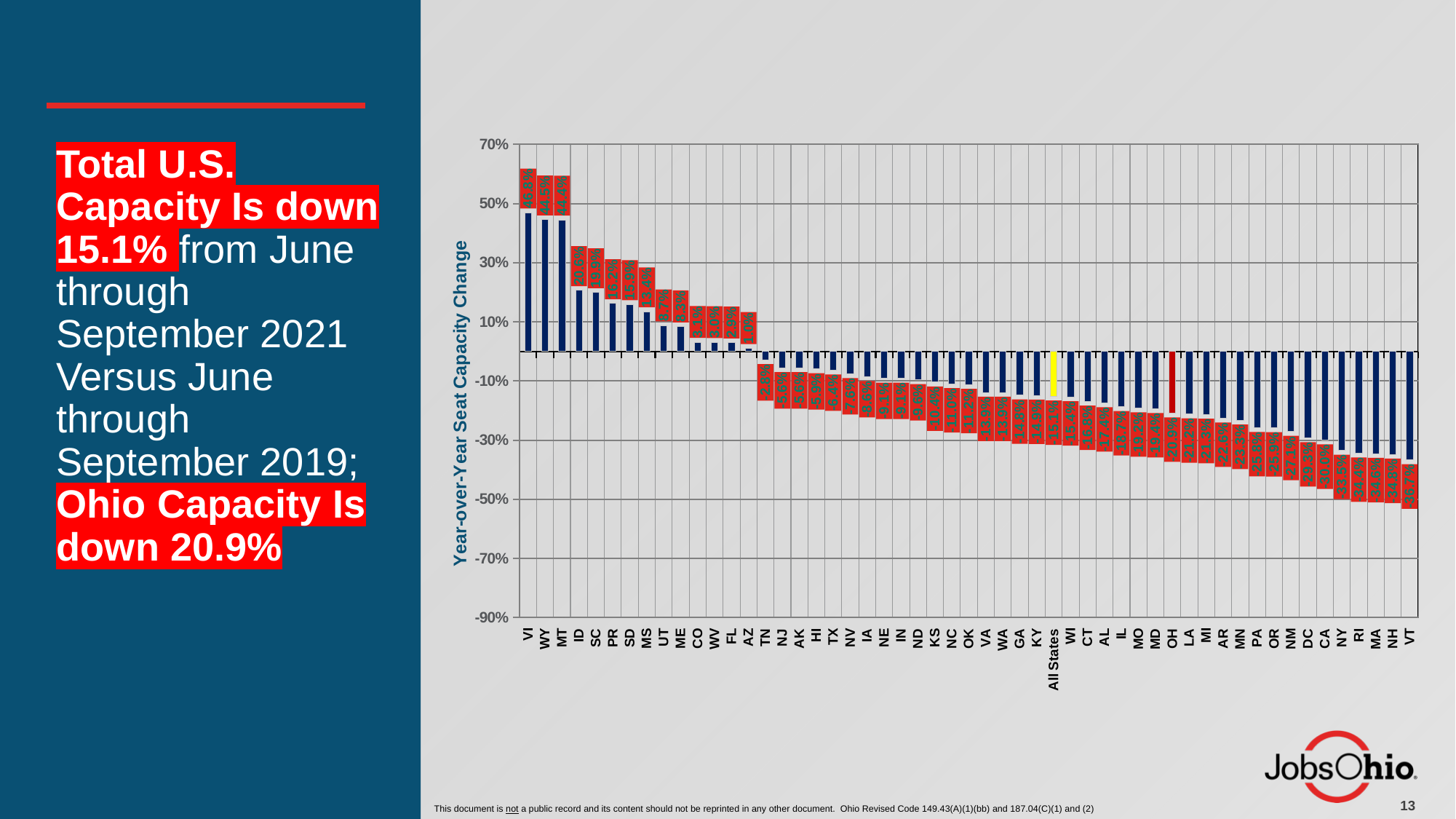
Is the value for ID greater or less than 10%? greater Is the value for VT greater or less than -30%? less Which category has the lowest year-over-year seat capacity change? VT Which category has the highest year-over-year seat capacity change? VI What is the title of the chart's y axis? Year-over-Year Seat Capacity Change Which has the larger value, WY or ID? WY Do the values rise or fall moving from left to right along the x axis? fall By how much is total U.S. capacity down according to the slide? 15.1% Is the value for VI greater or less than 30%? greater How many categories are shown on the x axis of the chart? 53 What kind of chart is shown on the slide? bar chart By how much is Ohio's capacity down according to the slide? 20.9%